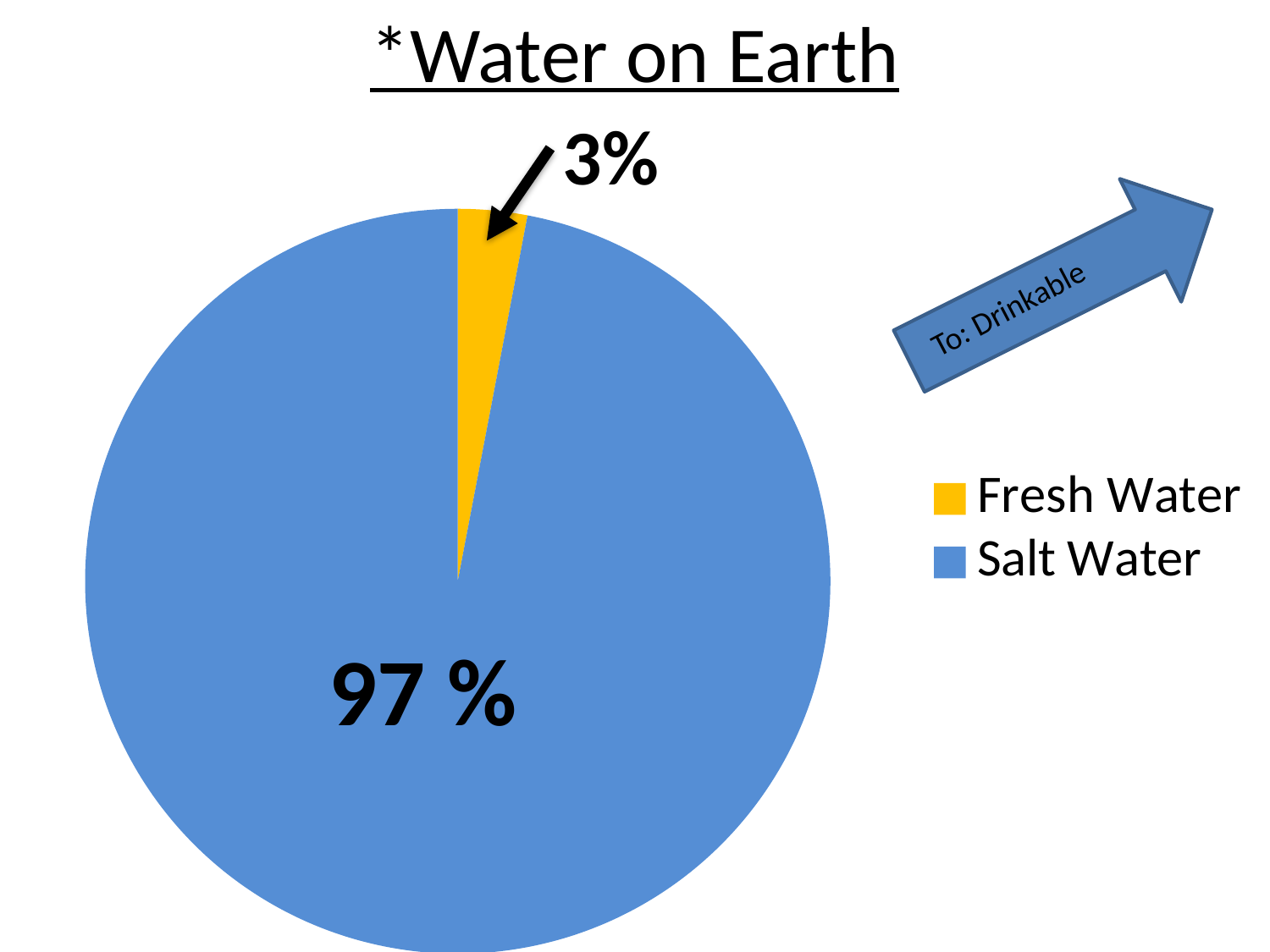
What share of the pie is Fresh Water? 3% How many categories does the pie chart show? 2 What kind of chart is shown on the slide? pie chart Which category has the smallest slice of the pie? Fresh Water How many entries does the legend list? 2 Which category has the largest slice of the pie? Salt Water What is the title of the chart? *Water on Earth Which is larger, the Fresh Water slice or the Salt Water slice? Salt Water What share of the pie is Salt Water? 97 % What is the difference in percentage points between the Salt Water and Fresh Water slices? 94 What colour is the Fresh Water slice? yellow